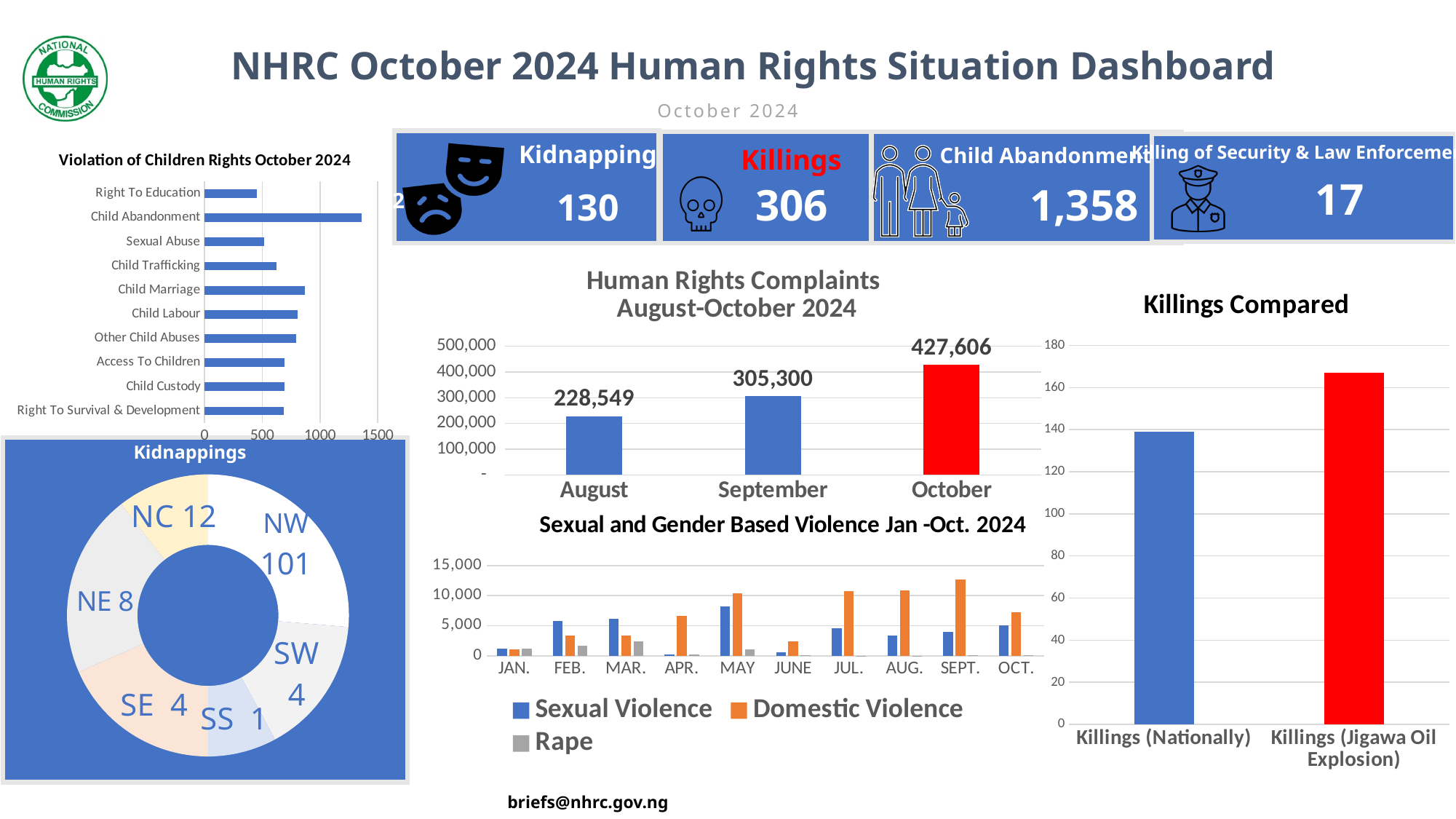
In the 'Human Rights Complaints August-October 2024' chart, do the values rise or fall from August to October? rise In the 'Kidnappings' donut chart, which region has the lowest value? SS In the 'Violation of Children Rights October 2024' chart, which category has the highest value? Child Abandonment In the 'Human Rights Complaints August-October 2024' chart, what is the value for September? 305,300 In the 'Violation of Children Rights October 2024' chart, is the value for Child Abandonment greater or less than 1000? greater In the 'Human Rights Complaints August-October 2024' chart, what is the difference between October and August? 199,057 In the 'Human Rights Complaints August-October 2024' chart, which month has the highest value? October In the 'Kidnappings' donut chart, what is the value for NW? 101 In the 'Kidnappings' donut chart, how many regions are shown? 6 In the 'Kidnappings' donut chart, which is larger, NC or NE? NC How many series does the legend of the 'Sexual and Gender Based Violence Jan -Oct. 2024' chart list? 3 In the 'Killings Compared' chart, is the value for Killings (Jigawa Oil Explosion) greater or less than 160? greater